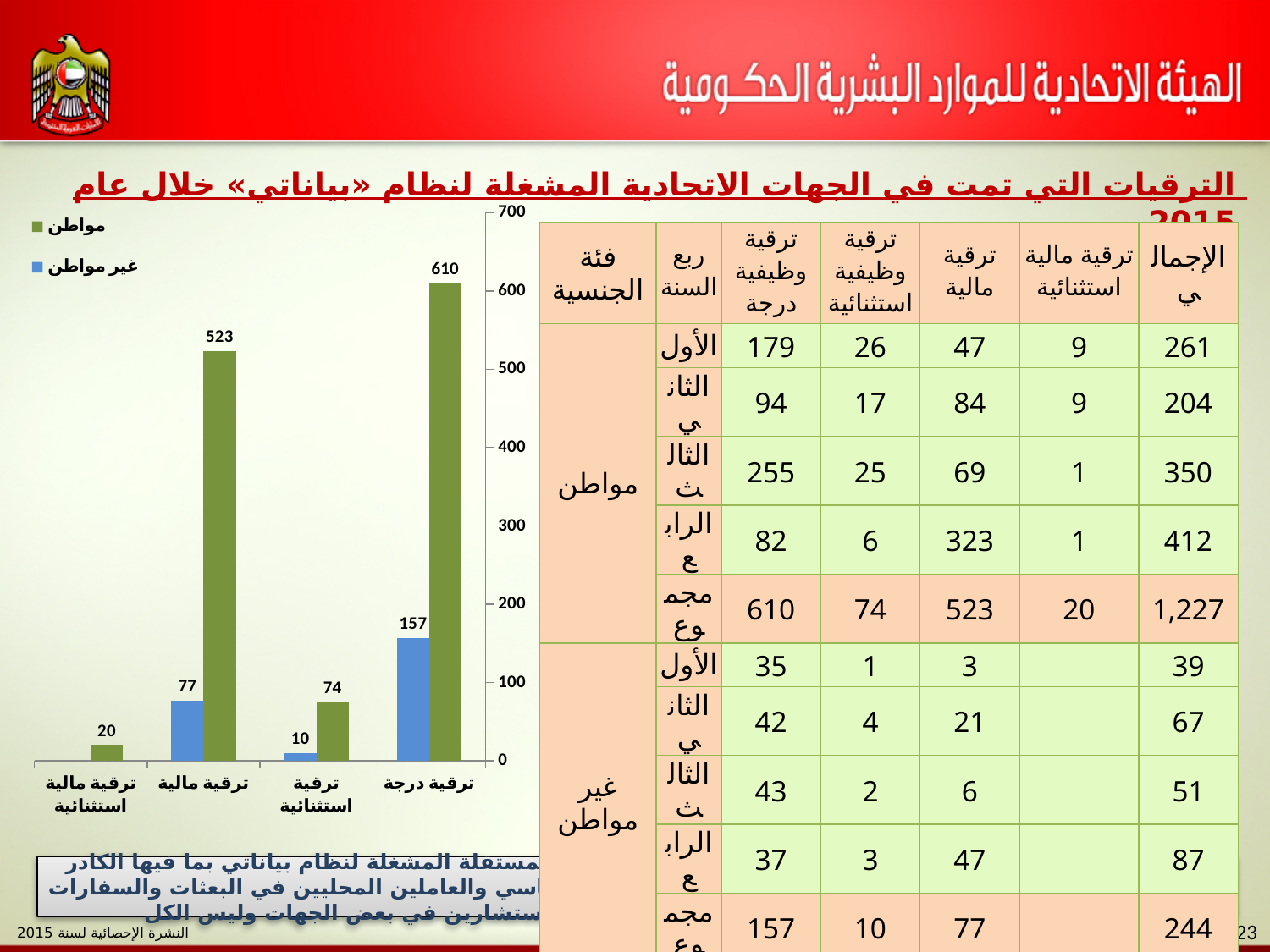
What is the difference between the مواطن and غير مواطن values for ترقية درجة? 453 Which is larger for ترقية مالية: the مواطن value or the غير مواطن value? مواطن What is the value of the غير مواطن series for ترقية مالية? 77 Which category has the lowest value for the مواطن series? ترقية مالية استثنائية What is the value of the مواطن series for ترقية مالية استثنائية? 20 What type of chart is shown on the left of the slide? bar chart How many series does the chart legend list? 2 What is the value of the مواطن series for ترقية درجة? 610 What is the value of the غير مواطن series for ترقية درجة? 157 What is the value of the مواطن series for ترقية مالية? 523 Which category has the highest value for the مواطن series? ترقية درجة How many categories are shown on the x axis of the bar chart? 4